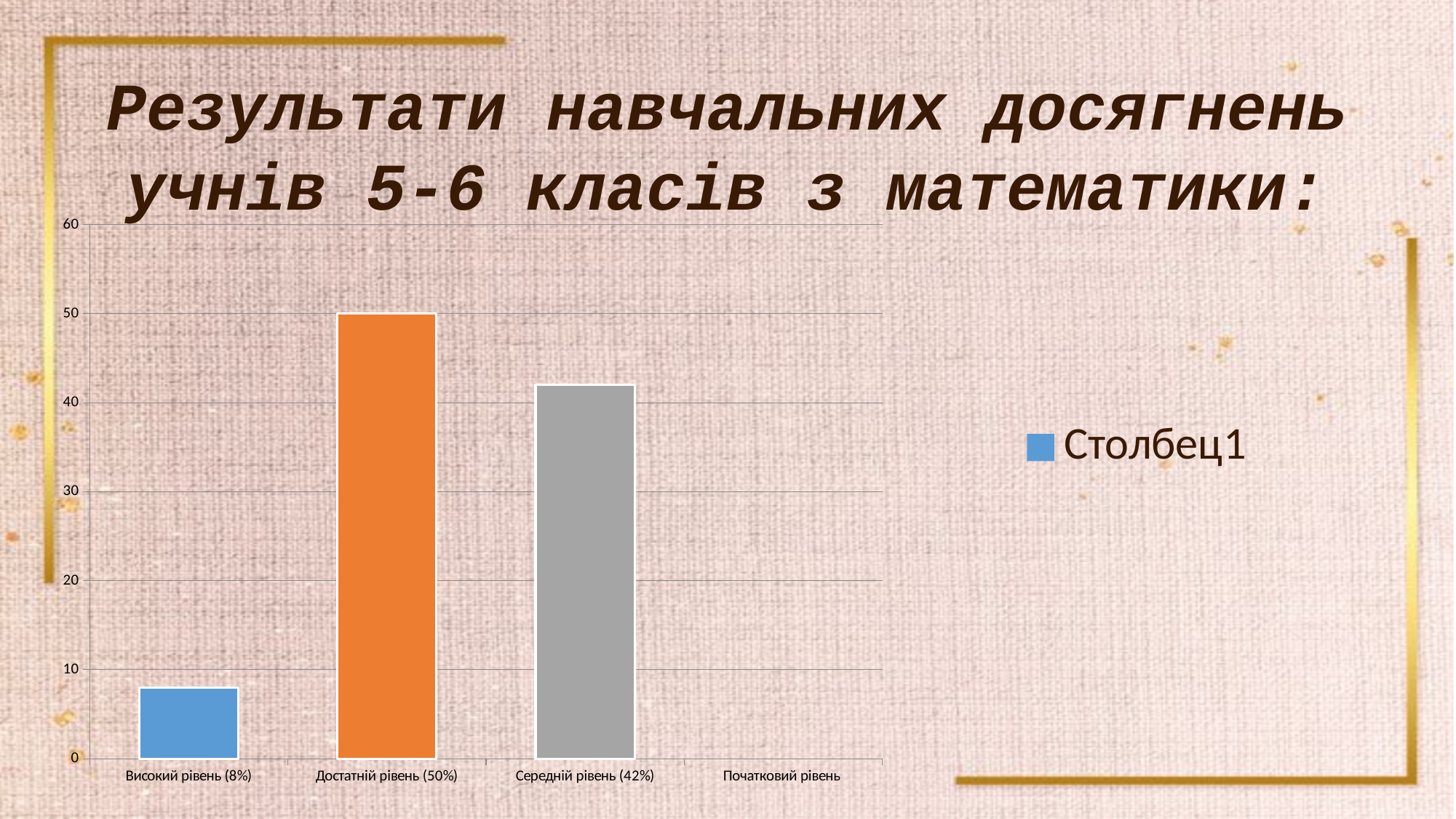
Which is larger, the value for Середній рівень or the value for Високий рівень? Середній рівень What value is shown for Високий рівень? 8% What is the difference between the values for Достатній рівень and Високий рівень? 42% Which category has the tallest bar? Достатній рівень (50%) What is the difference between the values for Достатній рівень and Середній рівень? 8% What kind of chart is shown on the slide? bar chart What value is shown for Достатній рівень? 50% Is the value for Середній рівень greater or less than 40? greater How many series does the legend list? 1 How many categories are shown on the x axis? 4 Which category has the shortest visible bar? Високий рівень (8%) What value is shown for Середній рівень? 42%